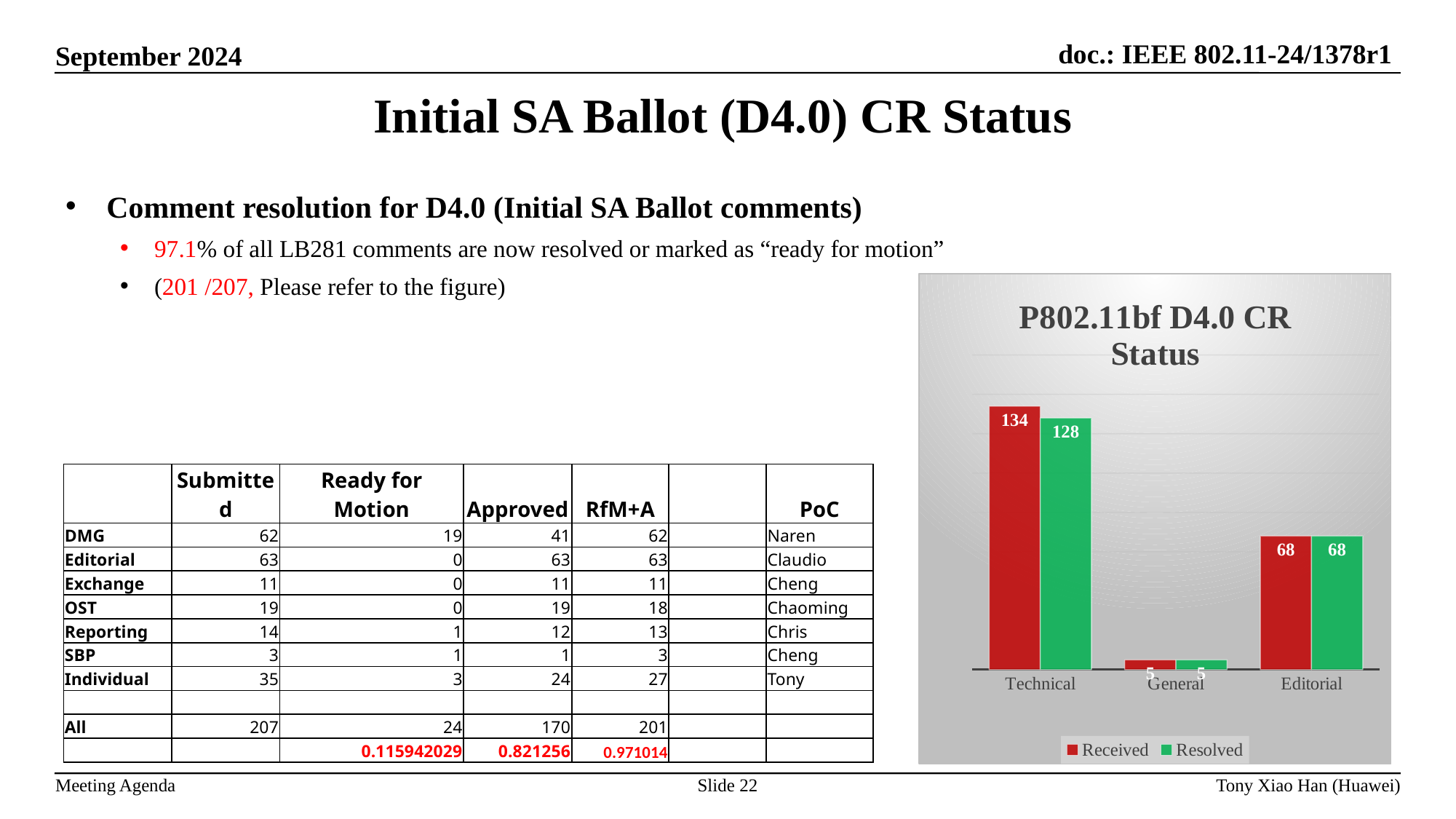
What is the Resolved value for General in the chart? 5 Which series is shown in red in the chart? Received Which category has the lowest Resolved value in the chart? General What is the Received value for Technical in the chart? 134 What is the Received value for Editorial in the chart? 68 What kind of chart is shown on the slide? bar chart What is the difference between the Received and Resolved values for Technical in the chart? 6 What is the Resolved value for Technical in the chart? 128 Which category has the highest Received value in the chart? Technical How many series does the chart's legend list? 2 How many categories are shown on the x axis of the chart? 3 What is the title of the chart on the slide? P802.11bf D4.0 CR Status